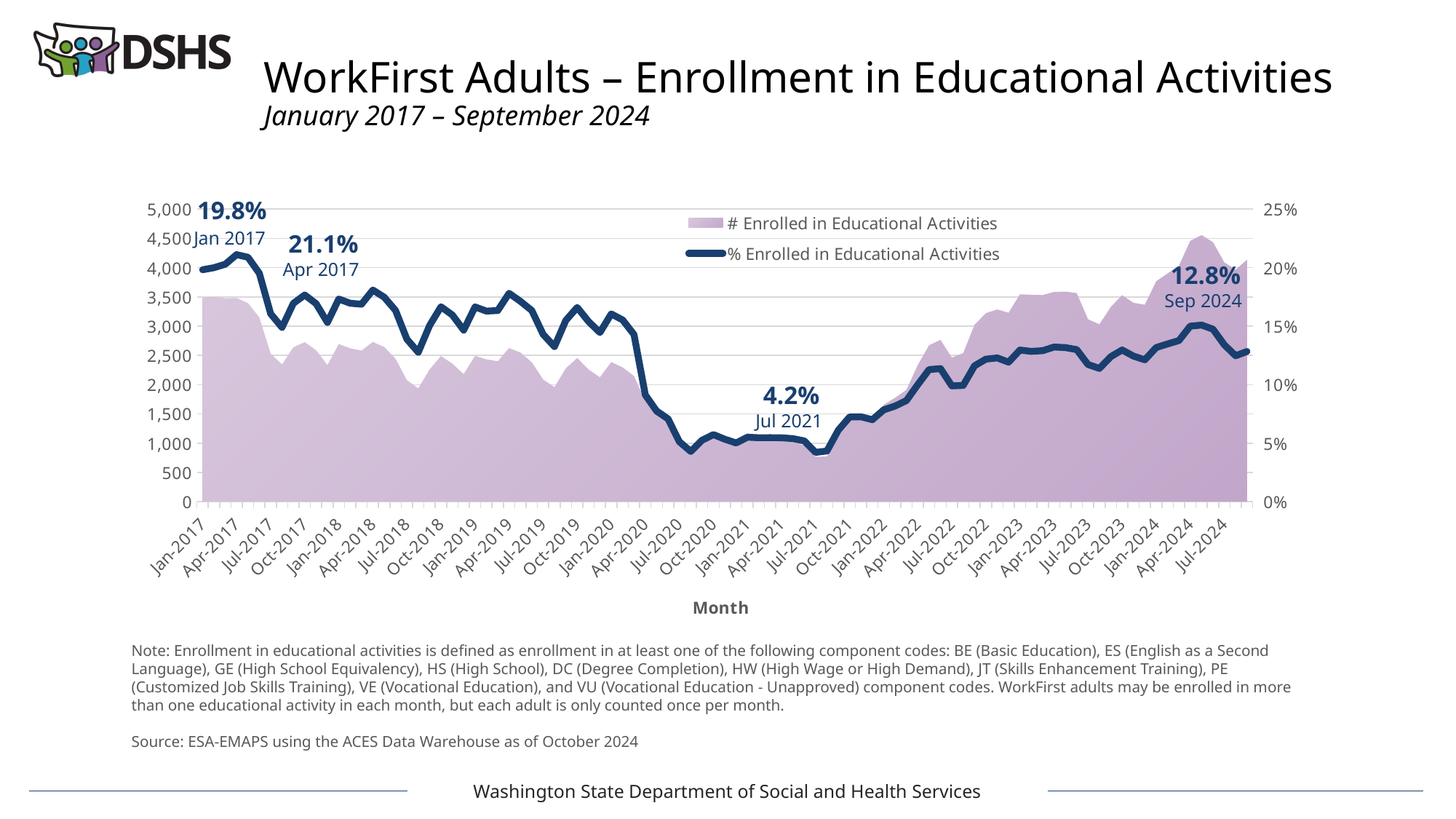
What is the difference in percentage points between the % enrolled in April 2017 and July 2021? 16.9 percentage points What was the % enrolled in educational activities in September 2024? 12.8% Is the number enrolled in educational activities in July 2021 greater or less than 1,500? less Is the number enrolled in educational activities in January 2017 greater or less than 3,000? greater What was the % enrolled in educational activities in April 2017? 21.1% Which labeled month has the highest % enrolled in educational activities? Apr 2017 What was the % enrolled in educational activities in January 2017? 19.8% Which is larger, the % enrolled in April 2017 or in September 2024? April 2017 Does the % enrolled in educational activities rise or fall between April 2017 and July 2021? fall What was the % enrolled in educational activities in July 2021? 4.2% How many series does the legend list? 2 Which labeled month has the lowest % enrolled in educational activities? Jul 2021